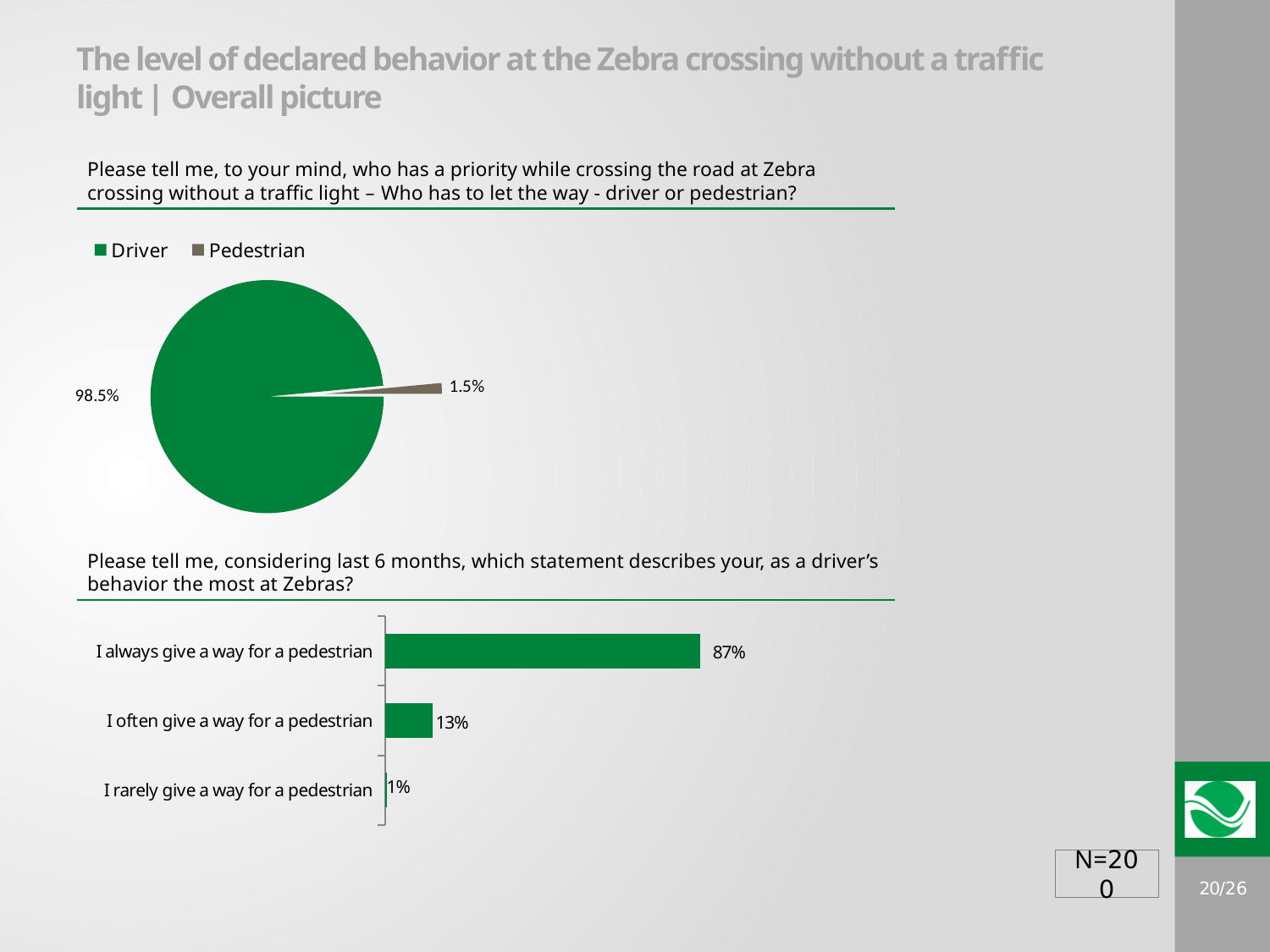
In the bottom bar chart, what is the value for 'I always give a way for a pedestrian'? 87% In the bottom bar chart, what is the value for 'I often give a way for a pedestrian'? 13% In the pie chart at the top of the slide, which category has the larger slice? Driver In the pie chart at the top of the slide, what share is shown for Pedestrian? 1.5% In the bottom bar chart, how many categories are shown? 3 In the bottom bar chart, what is the difference between 'I always give a way for a pedestrian' and 'I often give a way for a pedestrian'? 74% What kind of chart is the bottom chart on the slide? Bar chart In the bottom bar chart, which statement has the lowest value? I rarely give a way for a pedestrian In the pie chart at the top of the slide, what share is shown for Driver? 98.5% In the pie chart at the top of the slide, how many entries does the legend list? 2 What kind of chart is the top chart on the slide? Pie chart In the pie chart at the top of the slide, what is the difference between the Driver and Pedestrian shares? 97%